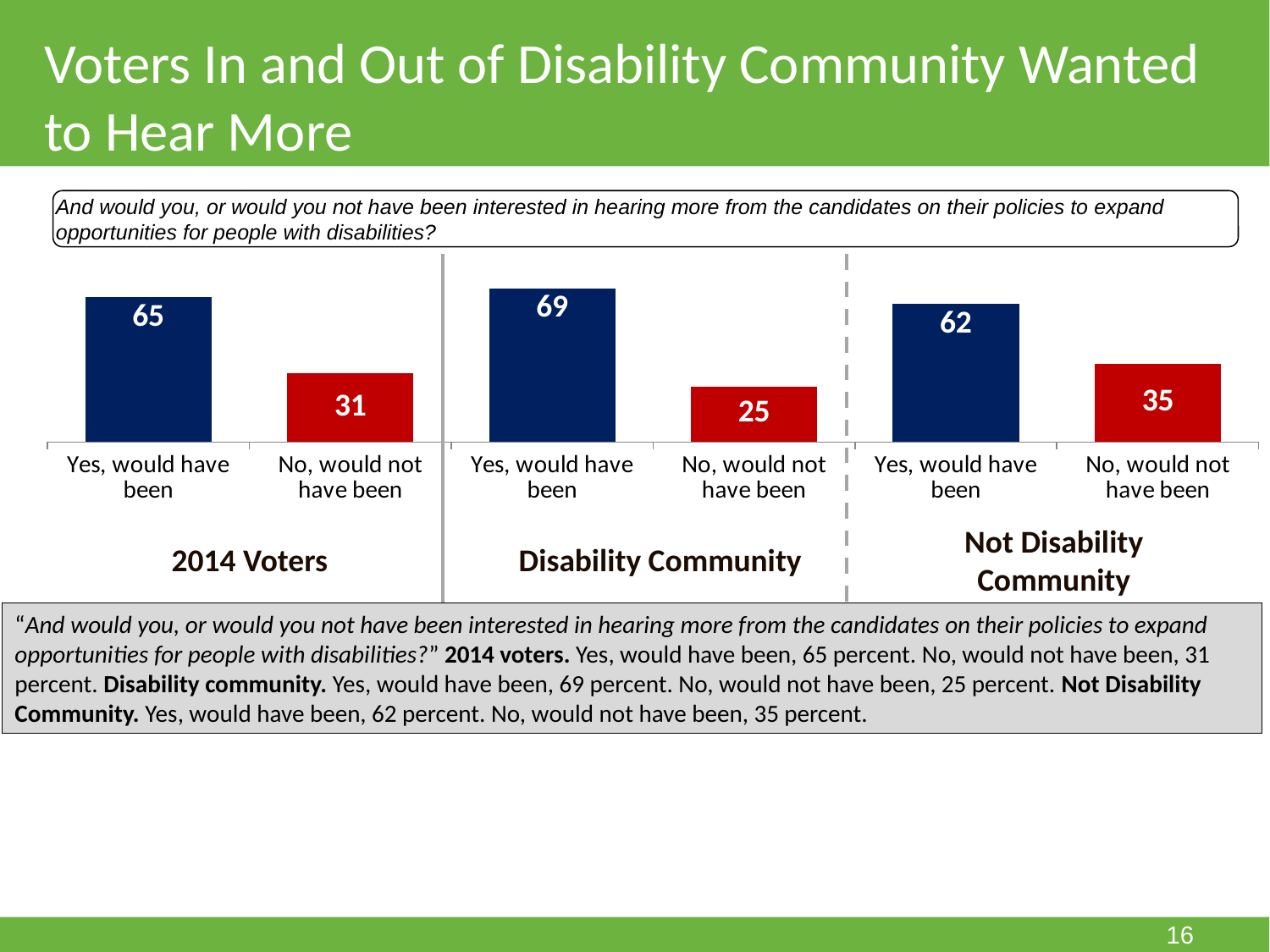
What kind of chart is shown on the slide? Bar chart How many bars are plotted on the chart in total? 6 What is the value for "Yes, would have been" in the Not Disability Community group? 62 Which is larger: "No, would not have been" for 2014 Voters or for the Not Disability Community? Not Disability Community What is the value for "No, would not have been" in the Disability Community group? 25 Which group has the lowest "No, would not have been" value? Disability Community Which group has the highest "Yes, would have been" value? Disability Community What is the difference between "Yes, would have been" and "No, would not have been" in the Disability Community group? 44 What colour are the "No, would not have been" bars? Red What is the value for "Yes, would have been" among 2014 Voters? 65 What is the difference between the "Yes, would have been" values for the Disability Community and the Not Disability Community? 7 What is the value for "No, would not have been" among 2014 Voters? 31